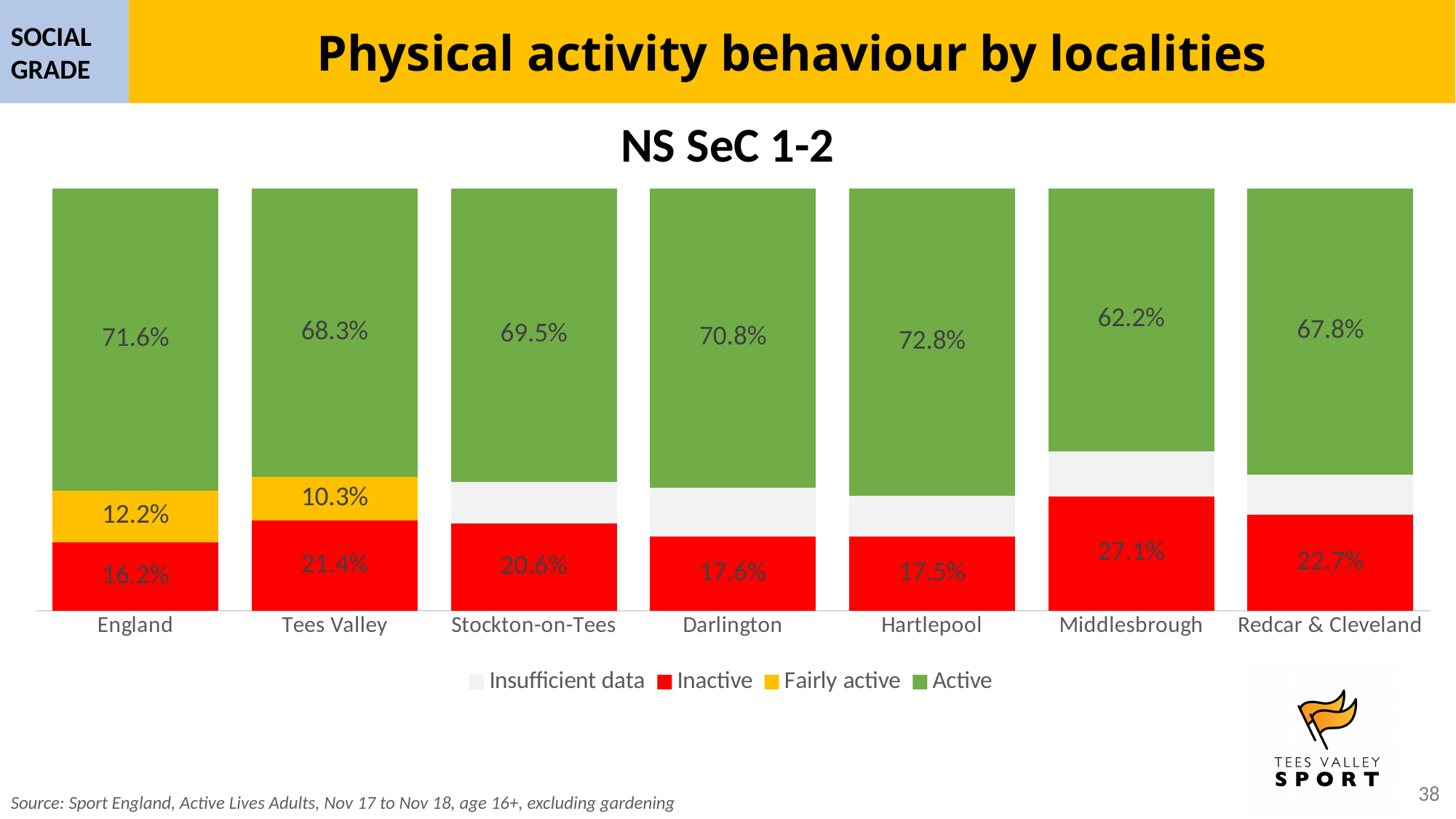
What is the Inactive value for Middlesbrough? 27.1% What is the Active value for Hartlepool? 72.8% How many localities are shown on the x axis? 7 Which locality has the lowest Active value? Middlesbrough What is the title of the chart? NS SeC 1-2 What kind of chart is shown? Stacked bar chart Which locality has the lowest Inactive value? England Which locality has the highest Active value? Hartlepool What is the difference between the Active values for Hartlepool and Middlesbrough? 10.6 percentage points How many series does the legend list? 4 What is the Fairly active value for Tees Valley? 10.3% Which has the larger Inactive value, Redcar & Cleveland or Stockton-on-Tees? Redcar & Cleveland